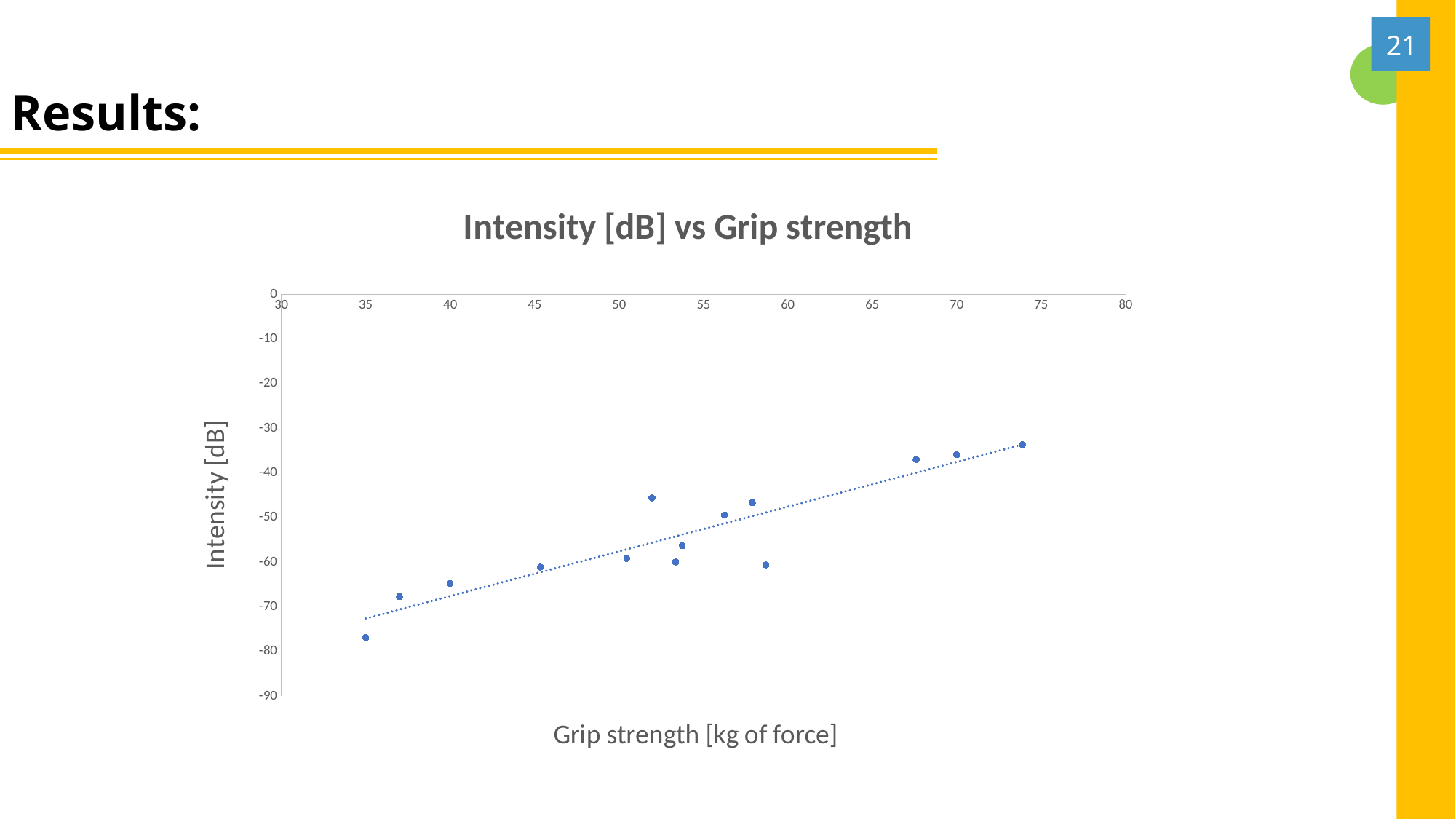
Is the intensity of the point with the lowest grip strength greater or less than -70? less What is the lowest value shown on the y axis? -90 Is the intensity of the point with the highest grip strength greater or less than -40? greater Which has the higher intensity: the point at a grip strength of about 35 or the point at about 74? The point at about 74 Is the intensity of the point at a grip strength of about 52 greater or less than -50? greater What kind of chart is shown on the slide? Scatter chart How many data points have a grip strength above 65 kg of force? 3 Does intensity rise or fall as grip strength increases along the x axis? Rise How many data points are plotted on the chart? 14 What is the title of the chart? Intensity [dB] vs Grip strength How many data points have an intensity above -40 dB? 3 What is the label of the x axis? Grip strength [kg of force]